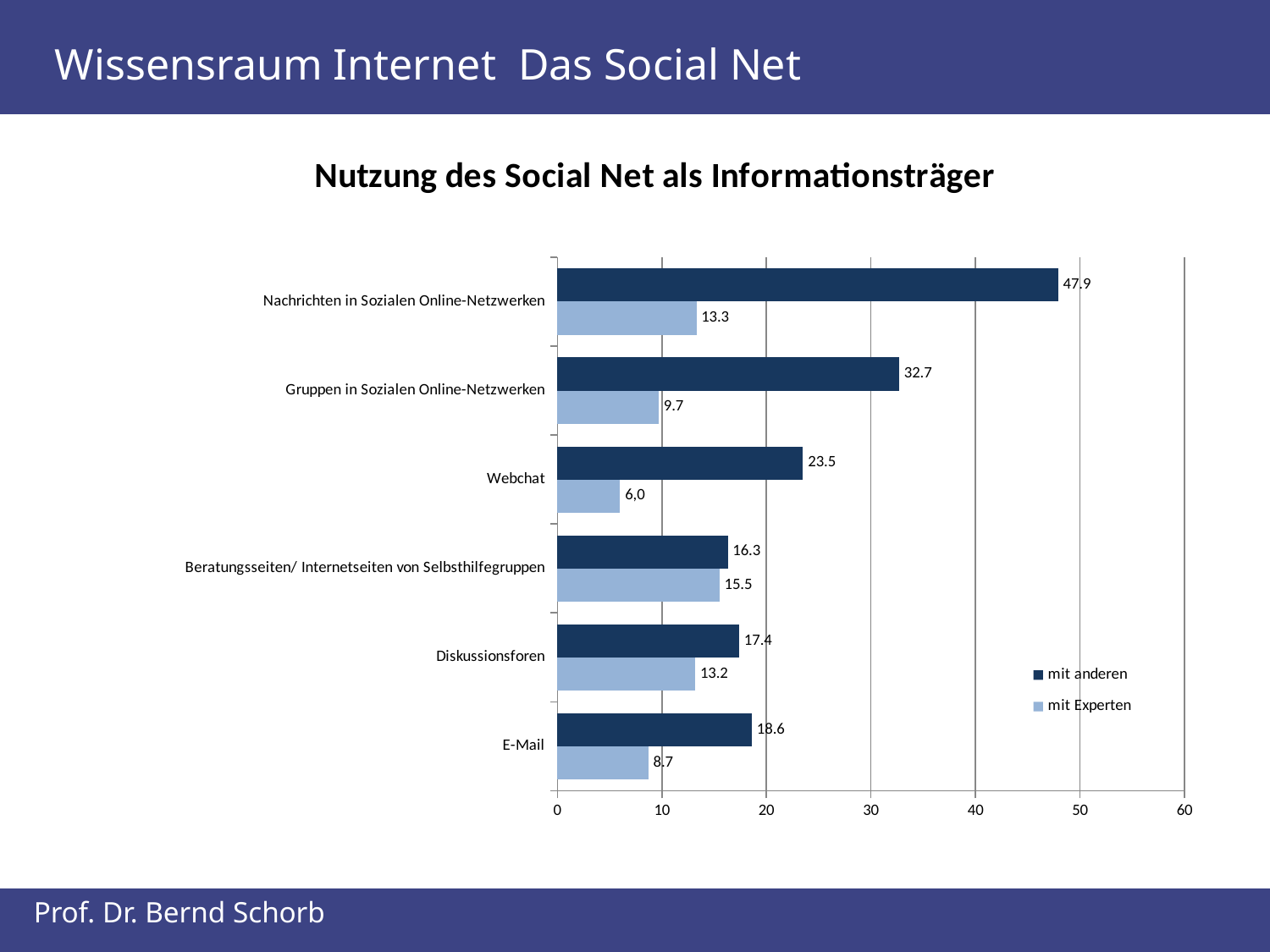
How many categories are shown on the chart? 6 What is the value for "mit Experten" for Beratungsseiten/ Internetseiten von Selbsthilfegruppen? 15.5 What is the value for "mit anderen" for E-Mail? 18.6 Which category has the lowest value for "mit Experten"? Webchat What is the value for "mit Experten" for Webchat? 6,0 What is the value for "mit anderen" for Nachrichten in Sozialen Online-Netzwerken? 47.9 How many series does the legend list? 2 Is the "mit anderen" value for Webchat greater or less than 20? greater Which is larger for Diskussionsforen: the "mit anderen" value or the "mit Experten" value? mit anderen Which category has the highest value for "mit anderen"? Nachrichten in Sozialen Online-Netzwerken What kind of chart is shown on the slide? Bar chart What is the difference between the "mit anderen" and "mit Experten" values for Gruppen in Sozialen Online-Netzwerken? 23.0